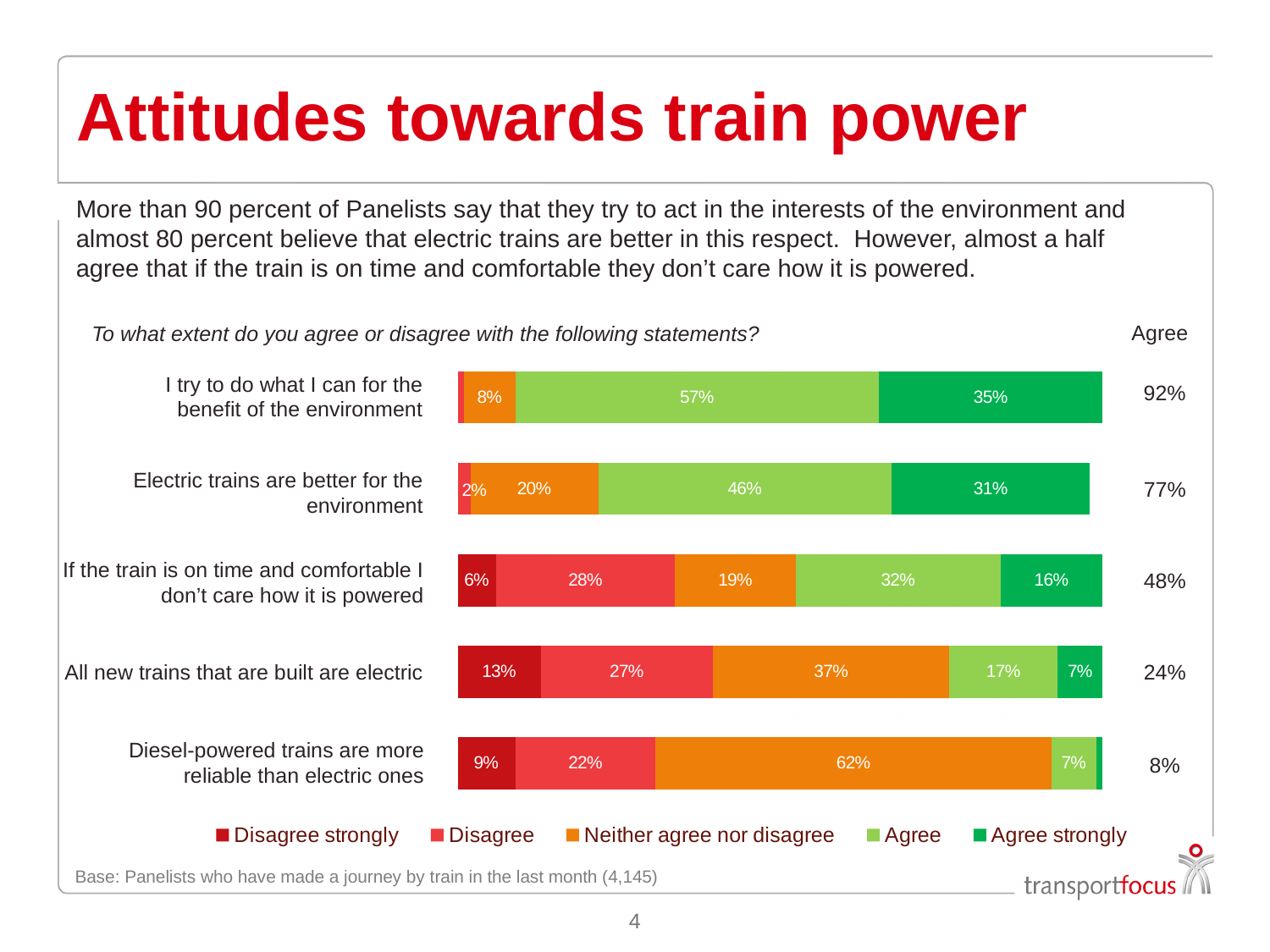
What type of chart is shown on the slide? Stacked bar chart What colour represents 'Agree strongly' in the chart? Dark green Which statement has the highest overall 'Agree' figure shown on the right? I try to do what I can for the benefit of the environment What percentage of panelists 'Agree' with the statement 'I try to do what I can for the benefit of the environment'? 57% What percentage 'Disagree strongly' that all new trains that are built are electric? 13% What is the difference between the 'Agree' and 'Agree strongly' percentages for 'If the train is on time and comfortable I don't care how it is powered'? 16% What percentage 'Neither agree nor disagree' that diesel-powered trains are more reliable than electric ones? 62% How many response categories does the legend list? 5 Which statement has the lowest overall 'Agree' figure shown on the right? Diesel-powered trains are more reliable than electric ones What percentage 'Agree strongly' that electric trains are better for the environment? 31% How many statements are shown in the chart? 5 Which is larger: the 'Disagree' share for 'All new trains that are built are electric' or the 'Disagree' share for 'Diesel-powered trains are more reliable than electric ones'? All new trains that are built are electric